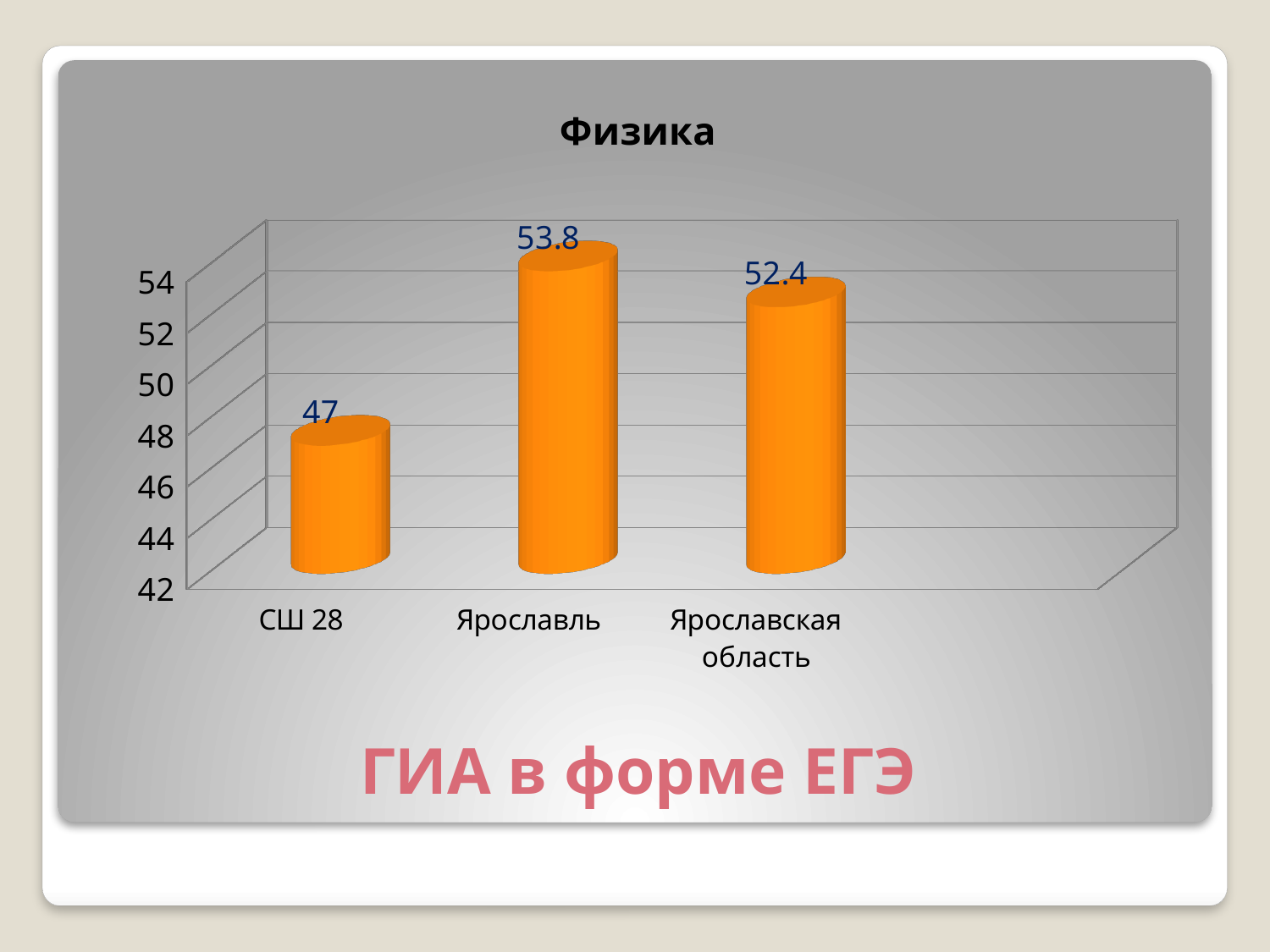
How many categories are shown in the chart? 3 Which category has the lowest value? СШ 28 What is the value for Ярославль? 53.8 What is the value for СШ 28? 47 What kind of chart is shown on the slide? bar chart What is the value for Ярославская область? 52.4 Which is larger, the value for Ярославская область or the value for СШ 28? Ярославская область Is the value for СШ 28 greater or less than 50? less What is the title of the chart? Физика What is the difference between the values for Ярославль and СШ 28? 6.8 What is the difference between the values for Ярославль and Ярославская область? 1.4 Which category has the highest value? Ярославль